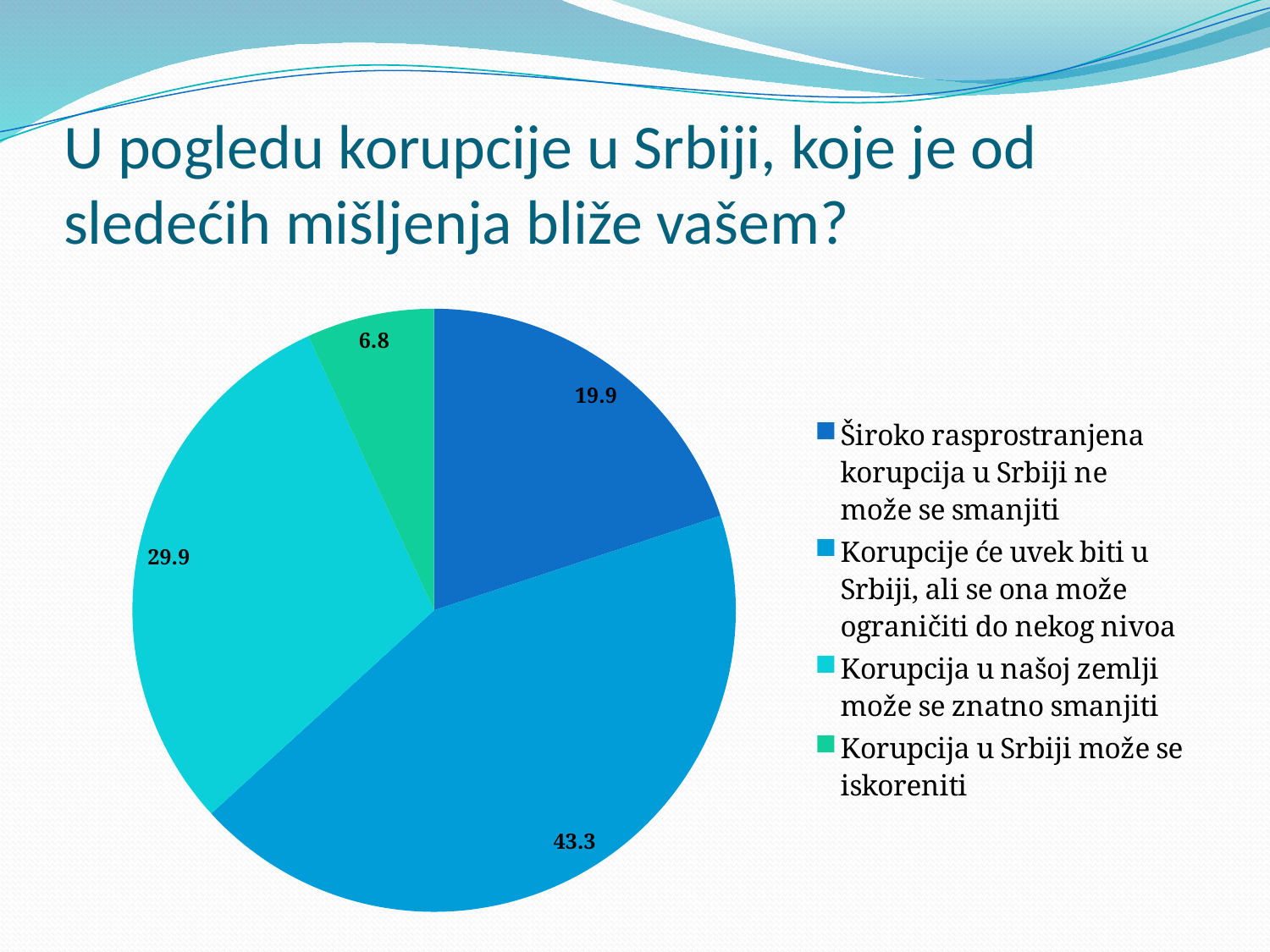
Which category has the smallest slice of the pie? Korupcija u Srbiji može se iskoreniti Which is larger: the value for "Široko rasprostranjena korupcija u Srbiji ne može se smanjiti" or the value for "Korupcija u Srbiji može se iskoreniti"? Široko rasprostranjena korupcija u Srbiji ne može se smanjiti Which category has the largest slice of the pie? Korupcije će uvek biti u Srbiji, ali se ona može ograničiti do nekog nivoa How many entries does the legend list? 4 What kind of chart is shown on the slide? pie chart What is the value for "Široko rasprostranjena korupcija u Srbiji ne može se smanjiti"? 19.9 What is the value for "Korupcija u Srbiji može se iskoreniti"? 6.8 What is the difference between the values for "Korupcije će uvek biti u Srbiji, ali se ona može ograničiti do nekog nivoa" and "Korupcija u našoj zemlji može se znatno smanjiti"? 13.4 What colour is the slice for "Korupcija u Srbiji može se iskoreniti"? green What is the value for "Korupcije će uvek biti u Srbiji, ali se ona može ograničiti do nekog nivoa"? 43.3 How many slices does the pie chart have? 4 What is the value for "Korupcija u našoj zemlji može se znatno smanjiti"? 29.9